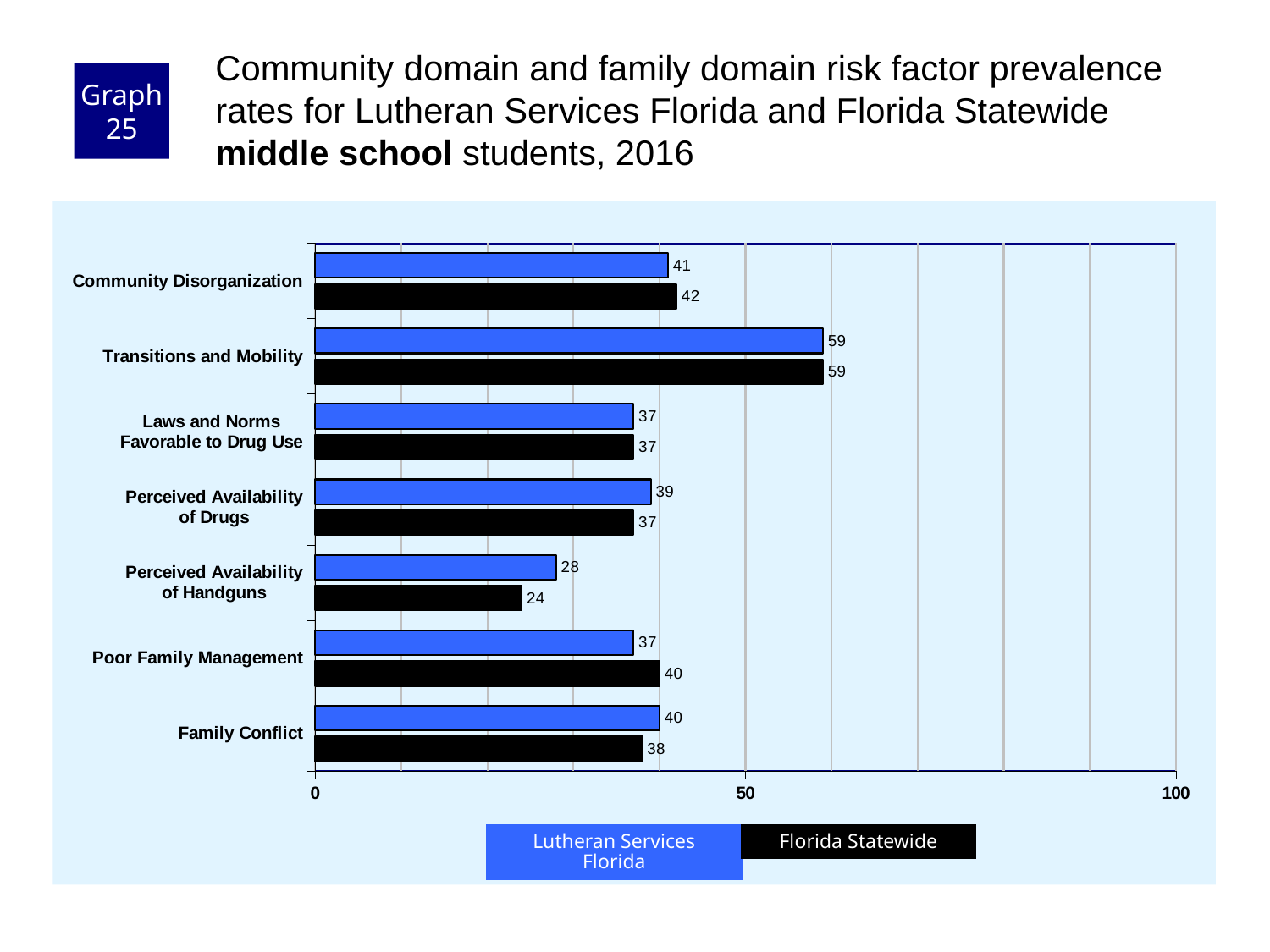
What kind of chart is shown on the slide? Bar chart Which risk factor has the lowest Florida Statewide value? Perceived Availability of Handguns What is the Florida Statewide value for Poor Family Management? 40 What is the Lutheran Services Florida value for Transitions and Mobility? 59 How many series does the legend list? 2 What is the Florida Statewide value for Perceived Availability of Handguns? 24 How many risk factors are shown on the chart? 7 Is the Florida Statewide value for Transitions and Mobility greater or less than 50? greater What is the Lutheran Services Florida value for Family Conflict? 40 For Poor Family Management, which is larger: the Lutheran Services Florida value or the Florida Statewide value? Florida Statewide Which risk factor has the highest Lutheran Services Florida value? Transitions and Mobility What is the difference between the Lutheran Services Florida and Florida Statewide values for Perceived Availability of Handguns? 4